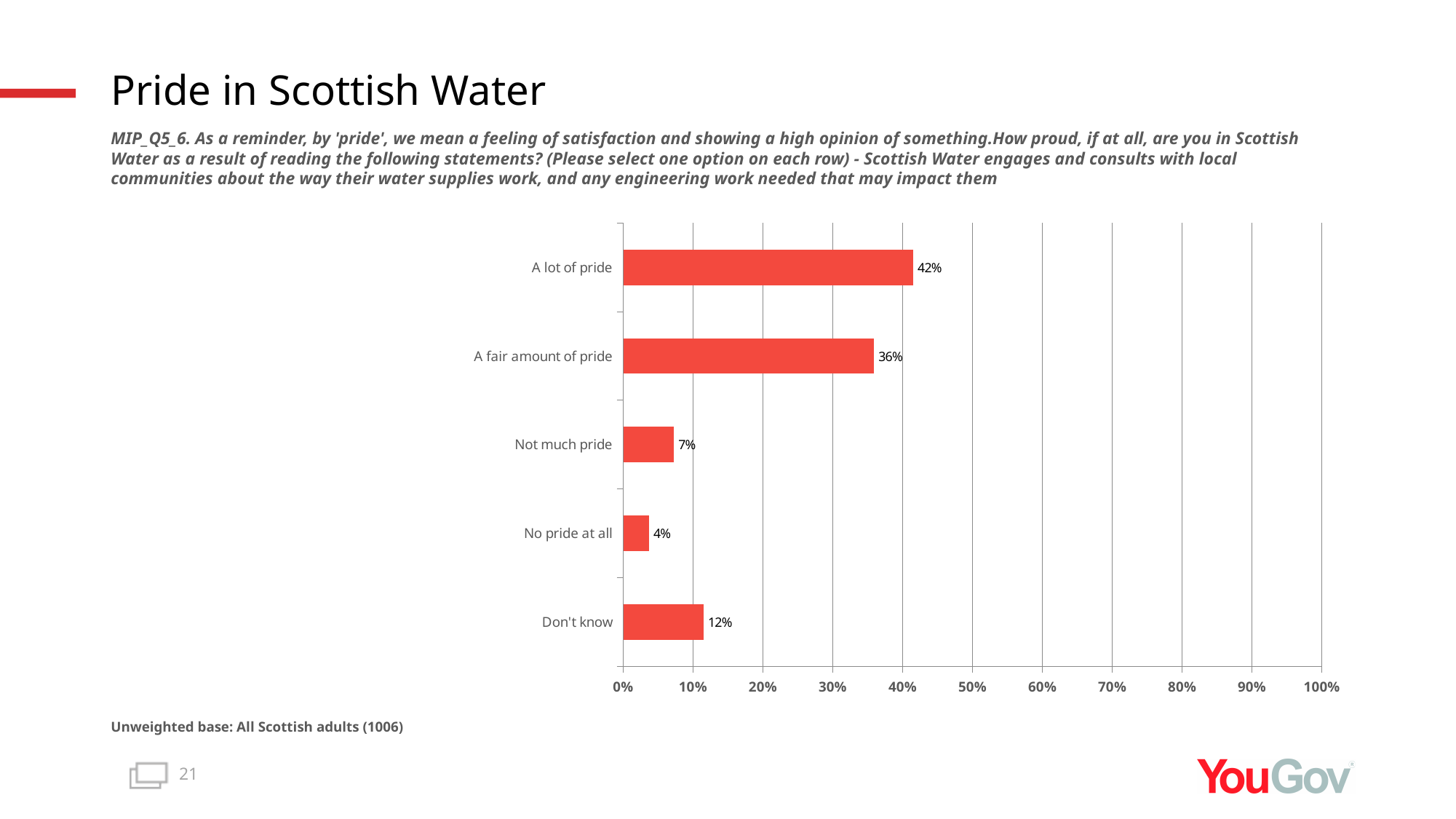
How many categories are shown in the chart? 5 What percentage of respondents said they feel 'A lot of pride'? 42% What is the value for 'A fair amount of pride'? 36% Which is larger, 'Not much pride' or 'Don't know'? Don't know Which category has the lowest value? No pride at all What is the difference between 'A lot of pride' and 'A fair amount of pride'? 6% Which category has the highest value? A lot of pride Is the value for 'A fair amount of pride' greater or less than 30%? greater What percentage answered 'Don't know'? 12% What kind of chart is shown on the slide? Bar chart What is the value for 'No pride at all'? 4% What is the title of the slide? Pride in Scottish Water